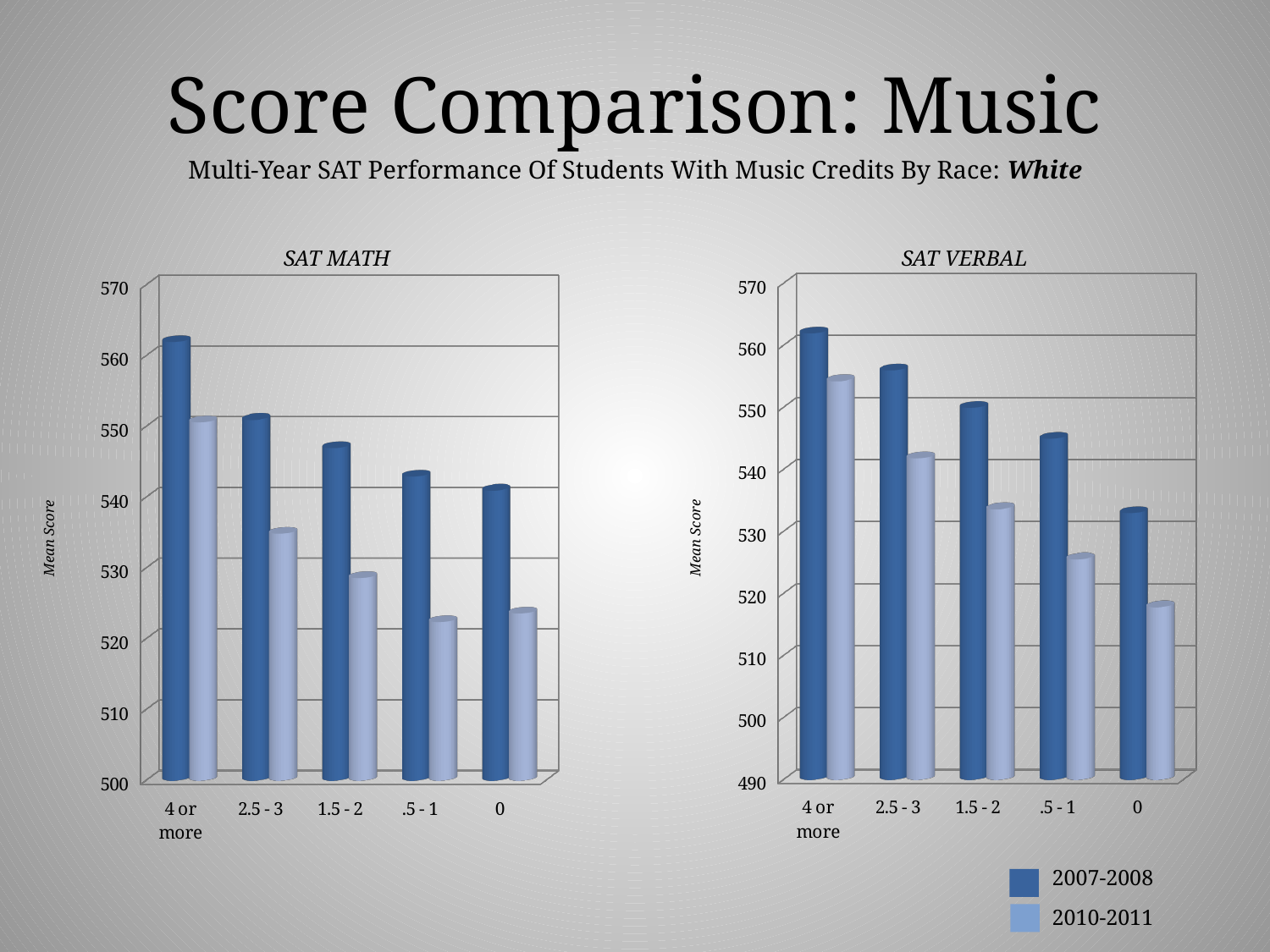
How many categories are shown on the x axis of the SAT VERBAL chart? 5 In the SAT VERBAL chart, do the 2007-2008 values rise or fall moving from "4 or more" to "0" along the x axis? fall In the SAT VERBAL chart, is the 2010-2011 value for "1.5 - 2" greater or less than 540? less In the SAT MATH chart, which category has the highest 2007-2008 value? 4 or more What kind of chart is the SAT MATH chart? bar chart How many series does the legend list for the charts? 2 In the SAT MATH chart, is the 2007-2008 value for "4 or more" greater or less than 550? greater What is the label on the vertical axis of the SAT VERBAL chart? Mean Score In the SAT VERBAL chart, which category has the lowest 2007-2008 value? 0 In the SAT MATH chart, is the 2010-2011 value for ".5 - 1" greater or less than 530? less In the SAT VERBAL chart, which category has the lowest 2010-2011 value? 0 In the SAT MATH chart, for the "2.5 - 3" category, which series has the larger value, 2007-2008 or 2010-2011? 2007-2008